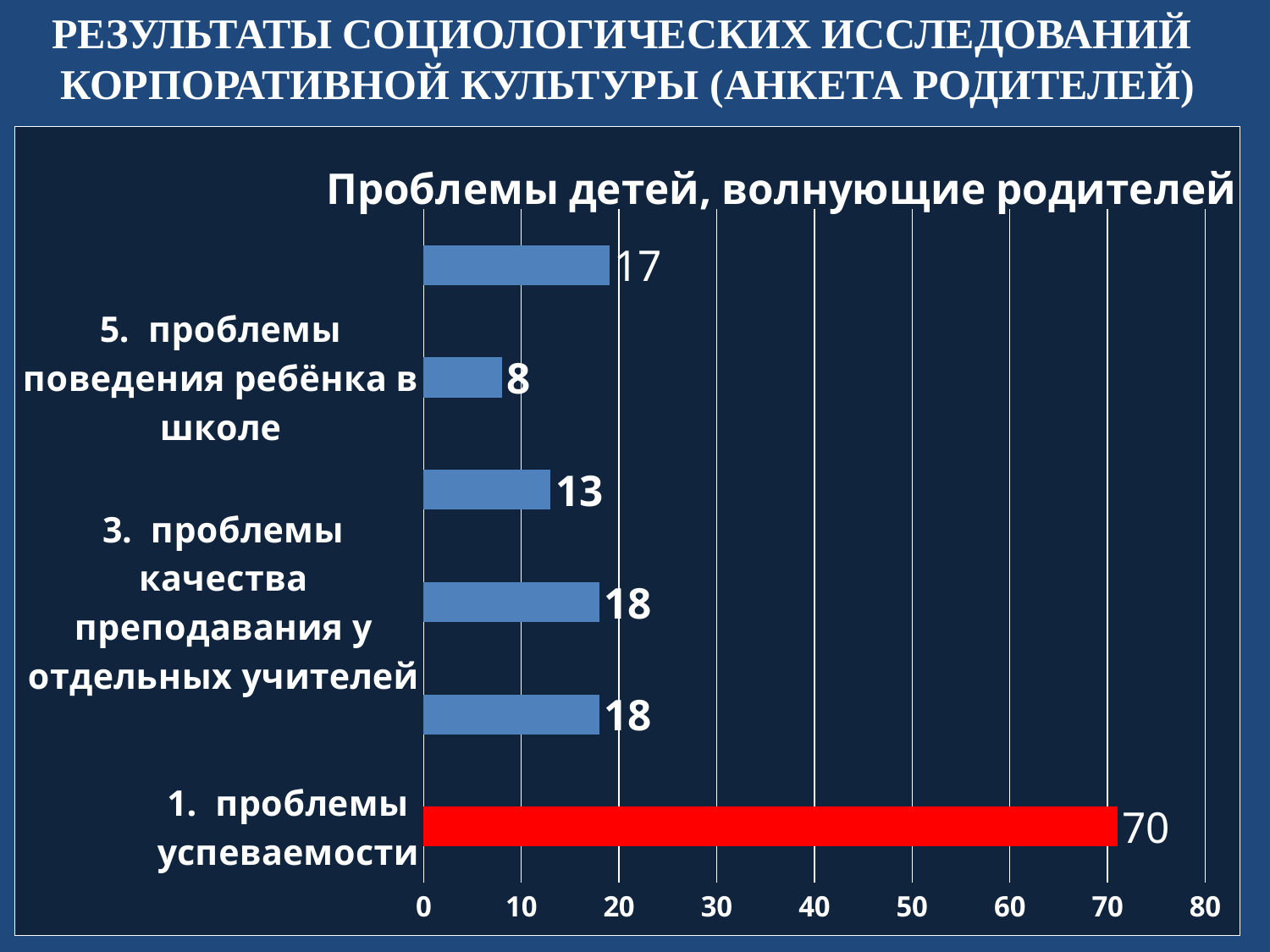
What kind of chart is shown on the slide? Bar chart Which category has the lowest value? 5. проблемы поведения ребёнка в школе Which is larger: the value for "3. проблемы качества преподавания у отдельных учителей" or for "5. проблемы поведения ребёнка в школе"? 3. проблемы качества преподавания у отдельных учителей How many bars are plotted in the chart? 6 What is the difference between the values for "1. проблемы успеваемости" and "5. проблемы поведения ребёнка в школе"? 62 What is the value for "1. проблемы успеваемости"? 70 What is the value for "5. проблемы поведения ребёнка в школе"? 8 Is the value for "1. проблемы успеваемости" greater or less than 60? greater What is the difference between the values for "1. проблемы успеваемости" and "3. проблемы качества преподавания у отдельных учителей"? 52 What is the title of the chart? Проблемы детей, волнующие родителей Which category has the highest value? 1. проблемы успеваемости What is the value for "3. проблемы качества преподавания у отдельных учителей"? 18